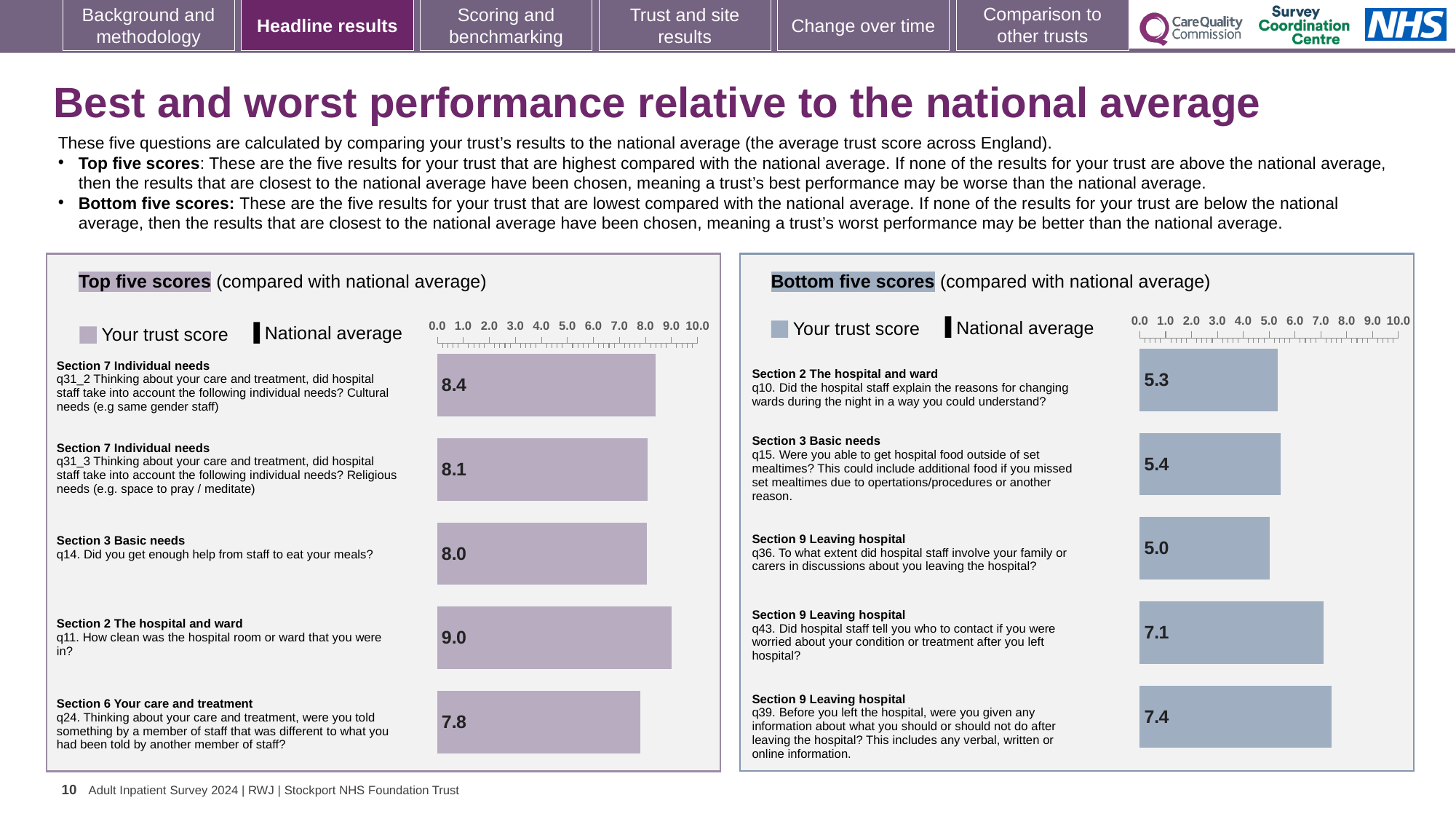
How many bars are plotted in the Top five scores chart? 5 In the Bottom five scores chart, which question has the lowest trust score? q36. To what extent did hospital staff involve your family or carers in discussions about you leaving the hospital? In the Top five scores chart, what is the trust score for q31_3 (religious needs)? 8.1 In the Top five scores chart, what is the difference between the trust scores for q11 and q24? 1.2 In the Bottom five scores chart, which has the larger trust score: q43 or q39? q39 In the Top five scores chart, what is the trust score for q11 (How clean was the hospital room or ward that you were in?)? 9.0 In the Bottom five scores chart, what is the trust score for q36 (involving family or carers in discussions about leaving hospital)? 5.0 How many series does the legend of the Bottom five scores chart list? 2 In the Bottom five scores chart, is the trust score for q10 greater or less than 6.0? less What kind of chart is the Top five scores chart? Bar chart In the Top five scores chart, which question has the highest trust score? q11. How clean was the hospital room or ward that you were in? In the Bottom five scores chart, what is the difference between the trust scores for q39 and q36? 2.4